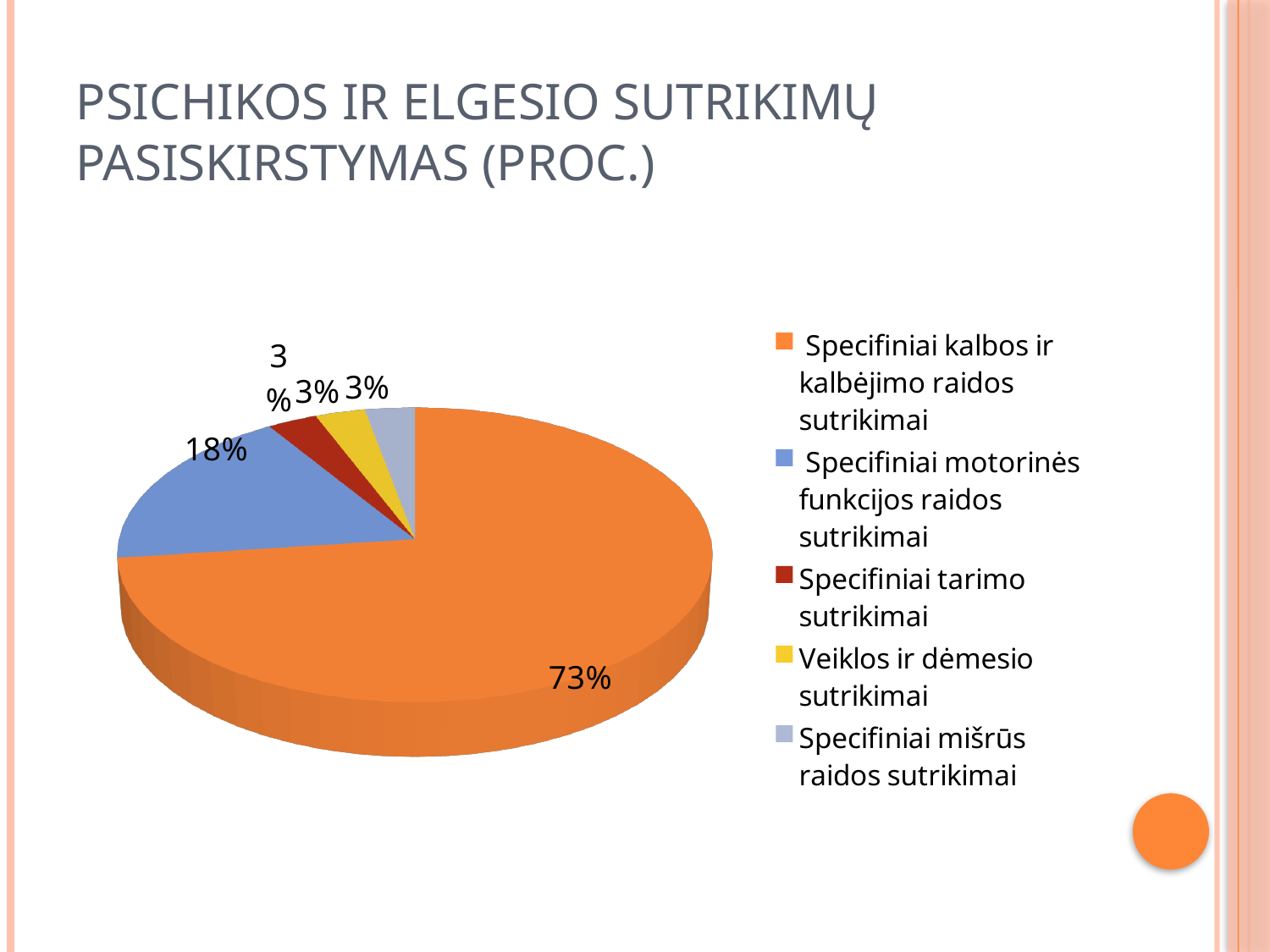
What share of the pie is Specifiniai tarimo sutrikimai? 3% What is the difference in percentage points between Specifiniai kalbos ir kalbėjimo raidos sutrikimai and Specifiniai motorinės funkcijos raidos sutrikimai? 55 What share of the pie is Specifiniai kalbos ir kalbėjimo raidos sutrikimai? 73% Which is larger: the slice for Specifiniai motorinės funkcijos raidos sutrikimai or the slice for Specifiniai mišrūs raidos sutrikimai? Specifiniai motorinės funkcijos raidos sutrikimai What kind of chart is shown on the slide? Pie chart What is the smallest percentage shown on the pie chart? 3% What share of the pie is Veiklos ir dėmesio sutrikimai? 3% Which colour represents Specifiniai tarimo sutrikimai in the legend? Red What is the title of the slide containing the chart? PSICHIKOS IR ELGESIO SUTRIKIMŲ PASISKIRSTYMAS (PROC.) Which category has the largest slice of the pie? Specifiniai kalbos ir kalbėjimo raidos sutrikimai How many slices does the pie chart have? 5 What share of the pie is Specifiniai motorinės funkcijos raidos sutrikimai? 18%